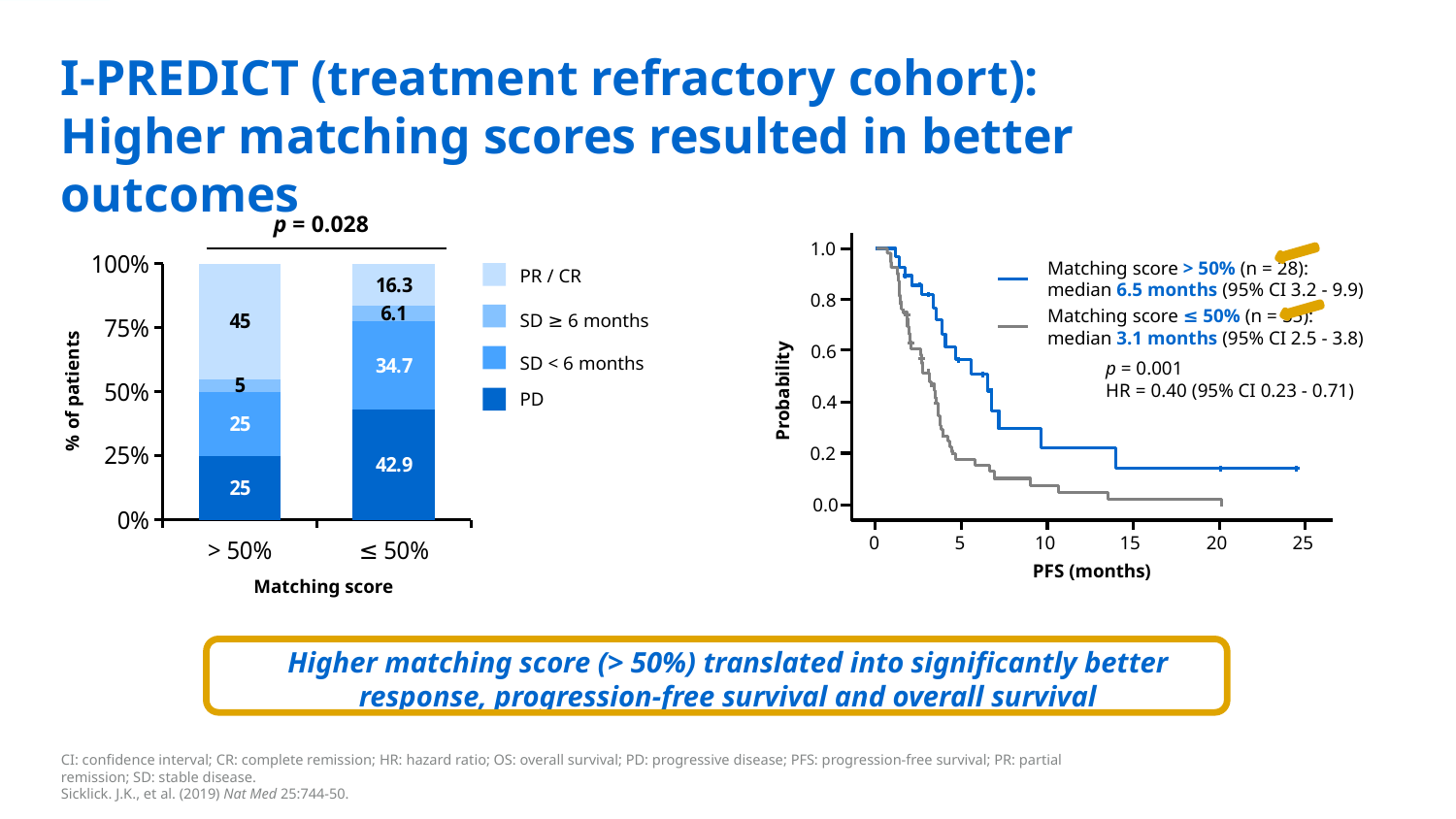
In the stacked bar chart on the left, what is the value for SD ≥ 6 months in the > 50% matching score group? 5 In the survival curve chart on the right, what is the median PFS for patients with a matching score > 50%? 6.5 months In the stacked bar chart on the left, what percentage of patients with a matching score ≤ 50% had PR / CR? 16.3 In the stacked bar chart on the left, what percentage of patients with a matching score > 50% had PD? 25 What p value is shown above the bar chart on the left? p = 0.028 How many matching score categories are shown on the x axis of the bar chart on the left? 2 In the stacked bar chart on the left, what is the difference between the PR / CR values for the > 50% and ≤ 50% groups? 28.7 How many series does the legend of the stacked bar chart on the left list? 4 In the survival curve chart on the right, what hazard ratio (HR) is reported? 0.40 What kind of chart is shown on the left of the slide? Stacked bar chart In the stacked bar chart on the left, what is the value for SD < 6 months in the ≤ 50% matching score group? 34.7 In the stacked bar chart on the left, which matching score group has the larger PD value? ≤ 50%